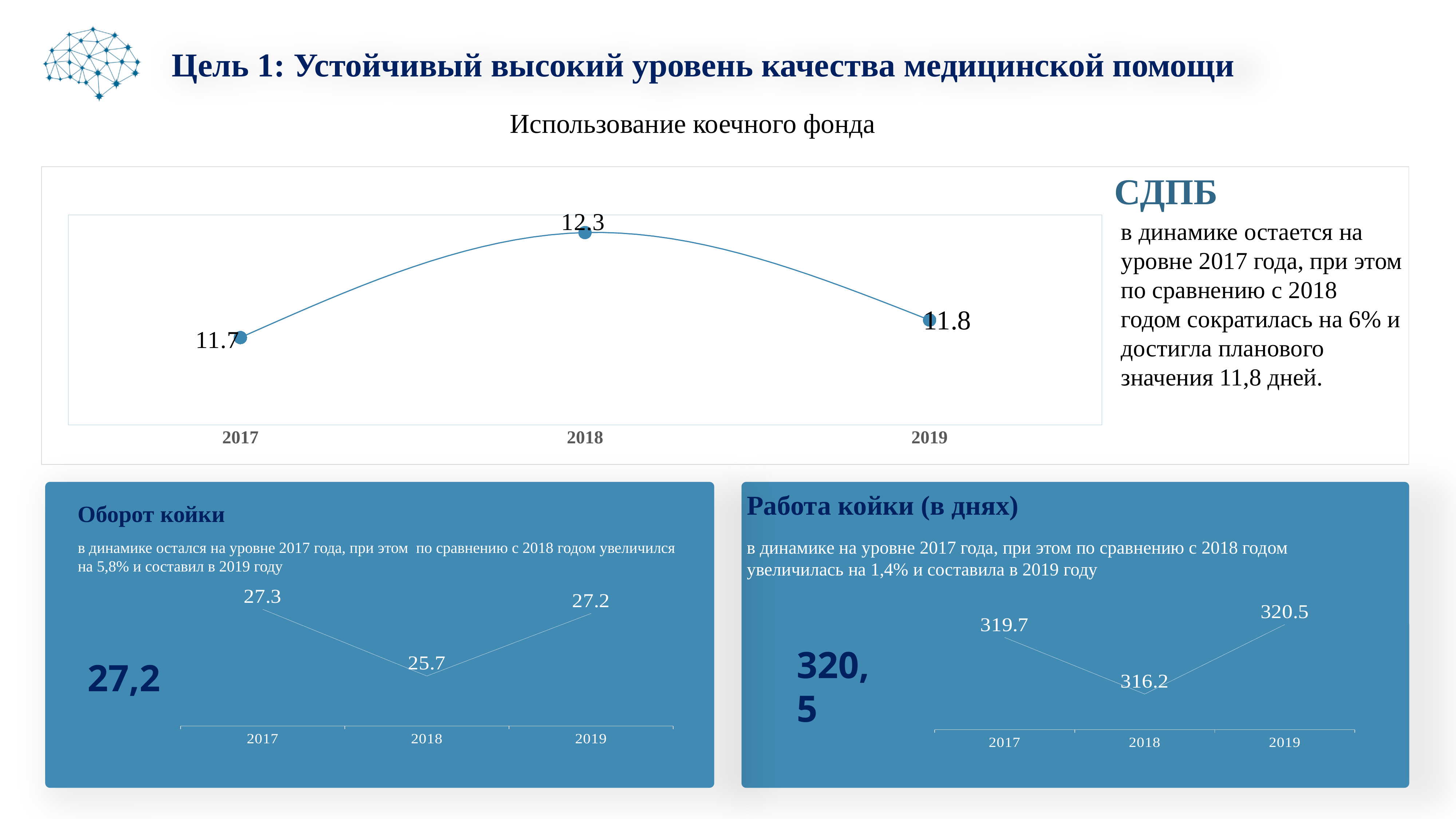
In the top chart (СДПБ), what is the difference between the 2018 and 2019 values? 0.5 In the top chart (СДПБ), what is the value for 2018? 12.3 In the top chart (СДПБ), what is the value for 2017? 11.7 In the bottom-left chart (Оборот койки), what is the value for 2018? 25.7 In the bottom-left chart (Оборот койки), is the value for 2017 or 2019 larger? 2017 In the top chart (СДПБ), how many data points are plotted? 3 In the bottom-right chart (Работа койки), does the value rise or fall from 2018 to 2019? Rise In the bottom-right chart (Работа койки), what is the difference between the 2019 and 2018 values? 4.3 What type of chart is the top chart (СДПБ)? Line chart In the bottom-left chart (Оборот койки), which year has the lowest value? 2018 In the bottom-right chart (Работа койки), what is the value for 2019? 320.5 In the top chart (СДПБ), which year has the highest value? 2018